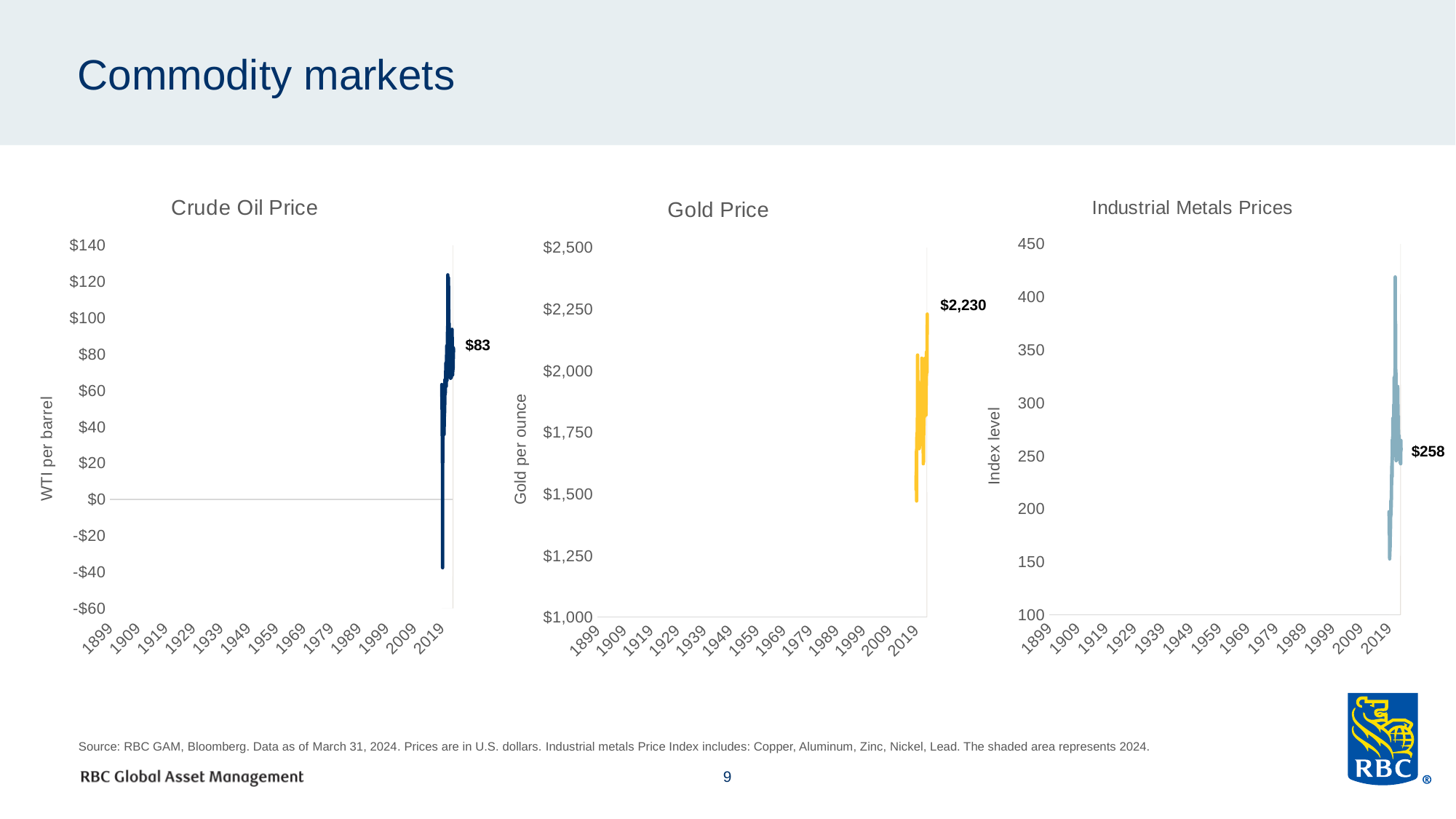
On the Industrial Metals Prices chart, is the highest point of the line greater or less than 400? greater On the Gold Price chart, what is the latest value shown by the data label? $2,230 On the Industrial Metals Prices chart, what is the latest value shown by the data label? $258 On the Crude Oil Price chart, is the lowest point of the line greater or less than $0? less On the Gold Price chart, is the highest point of the line greater or less than $2,000? greater On the Crude Oil Price chart, what is the latest value shown by the data label? $83 What is the y-axis label on the Industrial Metals Prices chart? Index level What kind of chart is the Crude Oil Price chart? line chart What is the y-axis label on the Crude Oil Price chart? WTI per barrel